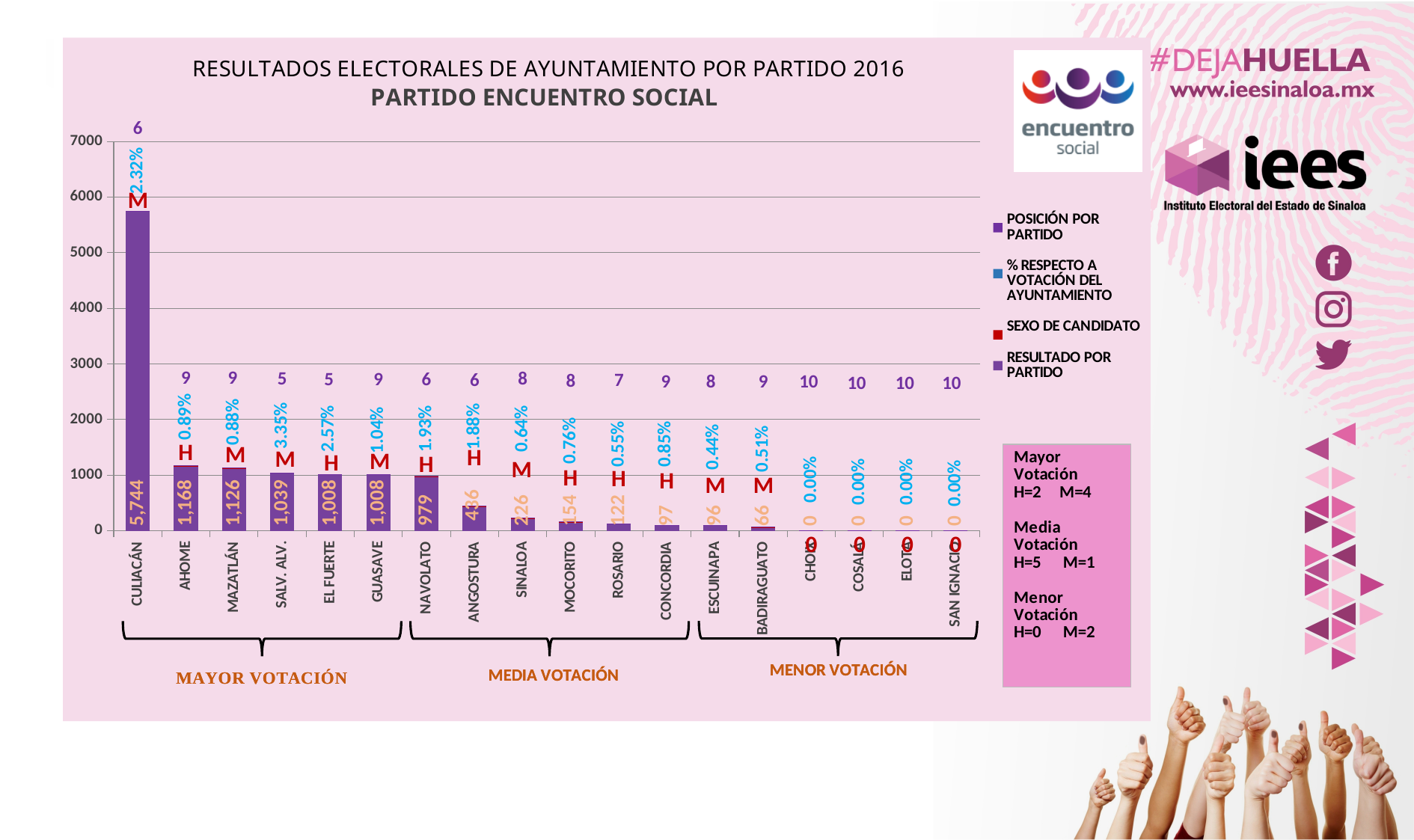
What is the number of votes (RESULTADO POR PARTIDO) shown for CULIACÁN? 5,744 How many series does the legend list? 4 Which party is named in the chart's subtitle? PARTIDO ENCUENTRO SOCIAL What kind of chart is shown on the slide? Bar chart How many municipalities are shown on the x axis of the chart? 18 Is the value for CULIACÁN greater or less than 5000? greater What is the number of votes shown for MOCORITO? 154 Which has more votes, NAVOLATO or ANGOSTURA? NAVOLATO Which municipality has the highest number of votes in the chart? CULIACÁN What percentage (% RESPECTO A VOTACIÓN DEL AYUNTAMIENTO) is shown for AHOME? 0.89% What is the difference in votes between CULIACÁN and AHOME? 4,576 What is the POSICIÓN POR PARTIDO value shown for SALV. ALV.? 5